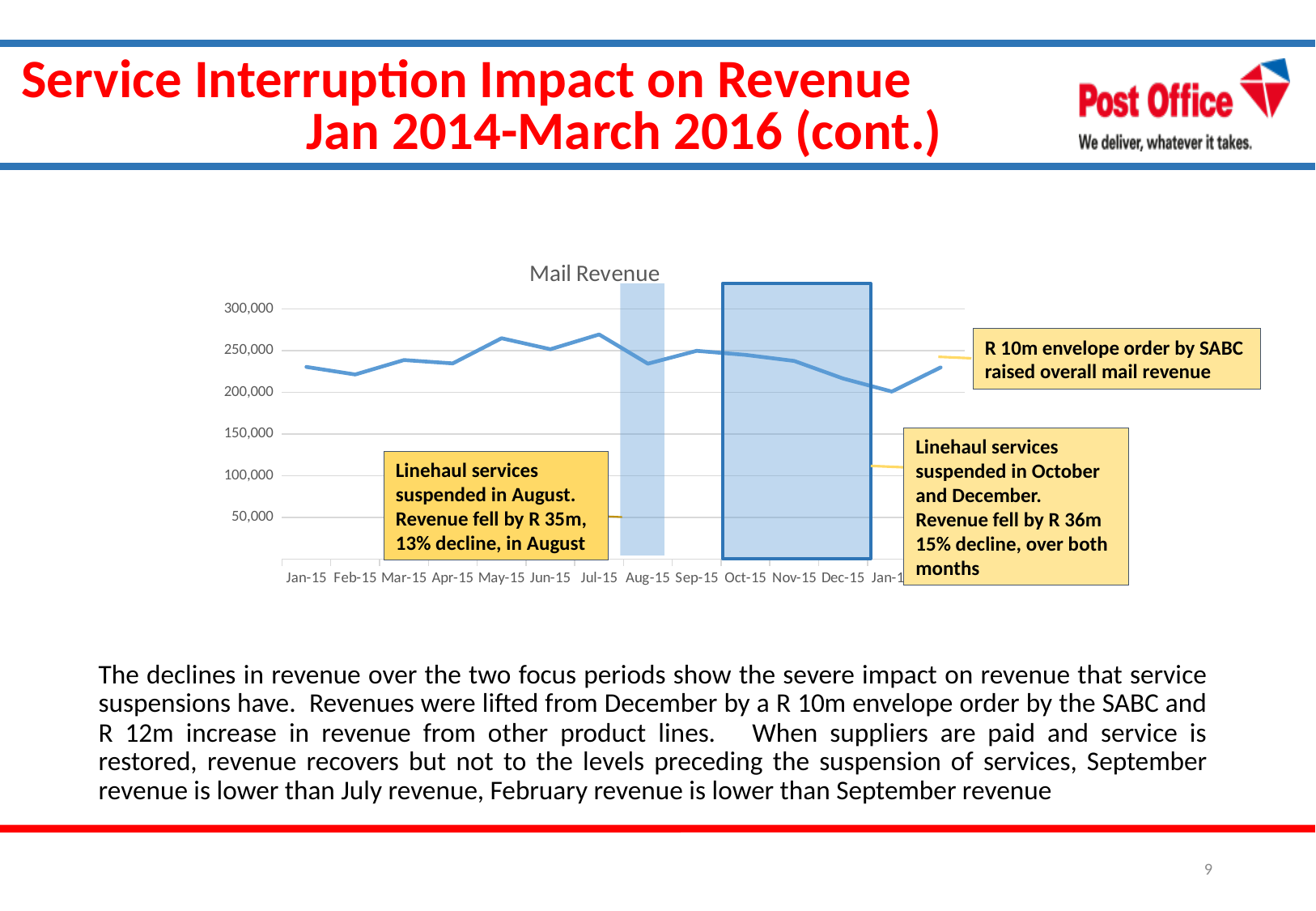
Which month has the lowest mail revenue on the chart? Jan-16 Does mail revenue rise or fall from Sep-15 to Jan-16? fall What kind of chart is shown on the slide? line chart Is the value for Feb-15 greater or less than 250,000? less Is the value for Jan-16 greater or less than 250,000? less What is the title of the chart? Mail Revenue Which is higher, the value for Jul-15 or the value for Aug-15? Jul-15 Is the value for May-15 greater or less than 200,000? greater Which is higher, the value for May-15 or the value for Feb-15? May-15 Does mail revenue rise or fall from Jan-15 to Feb-15? fall According to the callout on the chart, by what percentage did revenue decline in August? 13%